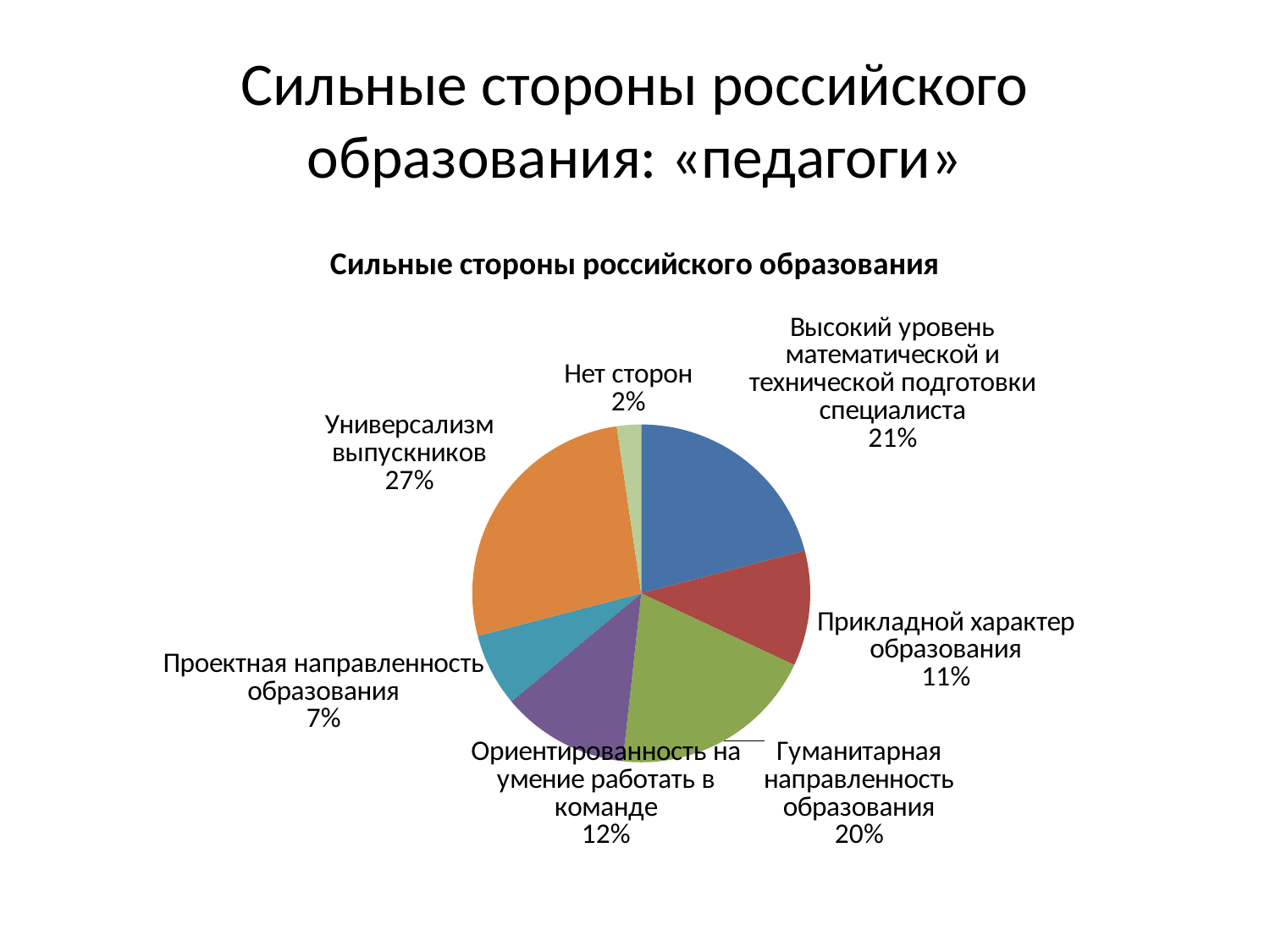
What colour is the slice for "Универсализм выпускников"? orange Which category has the smallest share? Нет сторон Which category has the largest share? Универсализм выпускников What share does "Высокий уровень математической и технической подготовки специалиста" have? 21% What is the chart's title? Сильные стороны российского образования What type of chart is shown on the slide? pie chart How many slices does the pie chart have? 7 Which is larger: the share of "Проектная направленность образования" or "Ориентированность на умение работать в команде"? Ориентированность на умение работать в команде What share does "Ориентированность на умение работать в команде" have? 12% What share does "Универсализм выпускников" have? 27% What is the difference between the shares of "Универсализм выпускников" and "Прикладной характер образования"? 16% What share does "Гуманитарная направленность образования" have? 20%